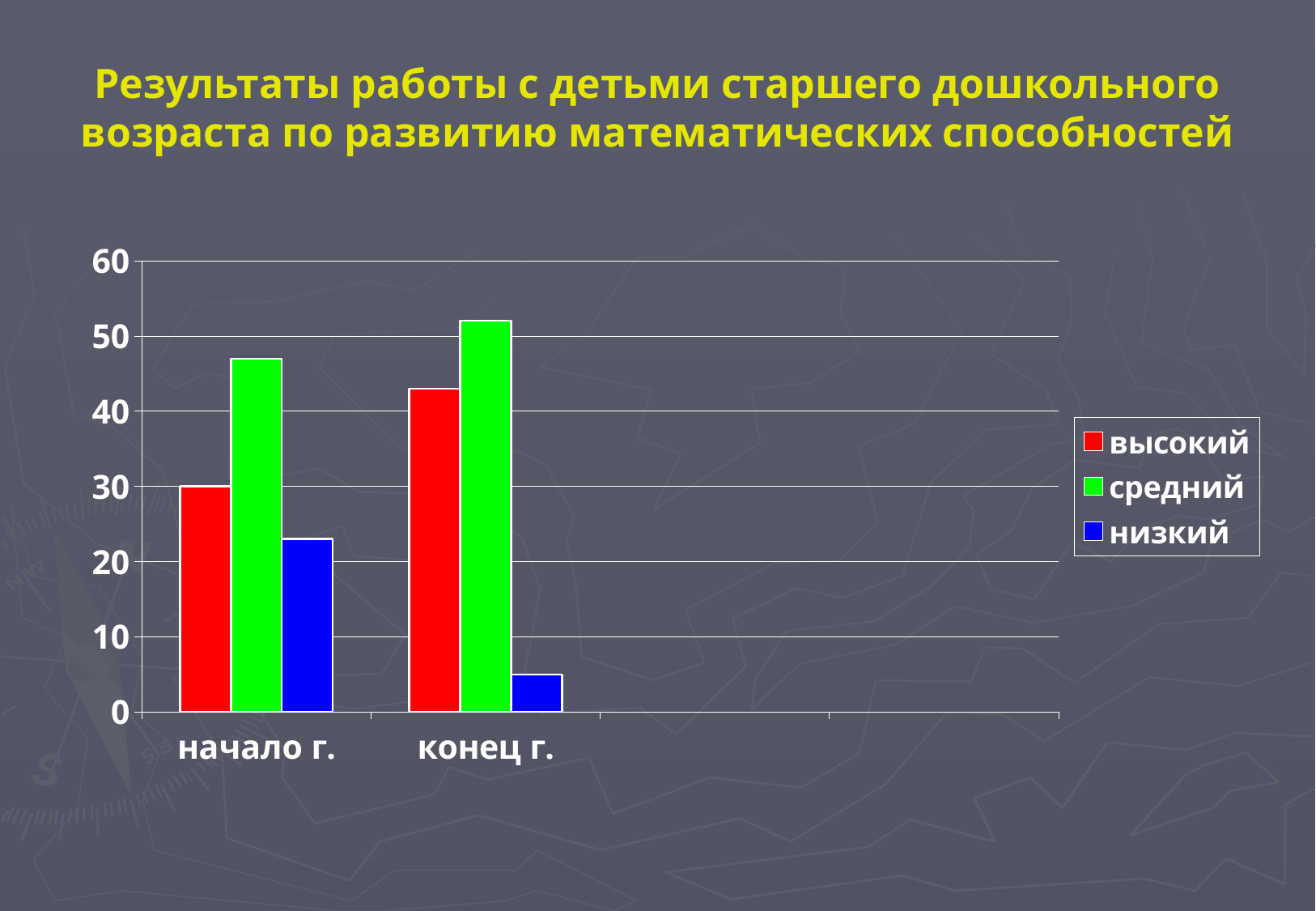
Which series has the highest value for "начало г."? средний What kind of chart is shown on the slide? bar chart Is the value for "низкий" at "конец г." greater or less than 10? less Does the value for "низкий" rise or fall from "начало г." to "конец г."? fall Is the value for "средний" at "конец г." greater or less than 50? greater How many series does the legend list? 3 Which series has the lowest value for "начало г."? низкий What colour represents the "средний" series in the legend? green Which is larger: "высокий" at "начало г." or "высокий" at "конец г."? высокий at конец г. Which series has the lowest value for "конец г."? низкий Which series has the highest value for "конец г."? средний How many categories are shown on the x axis? 2